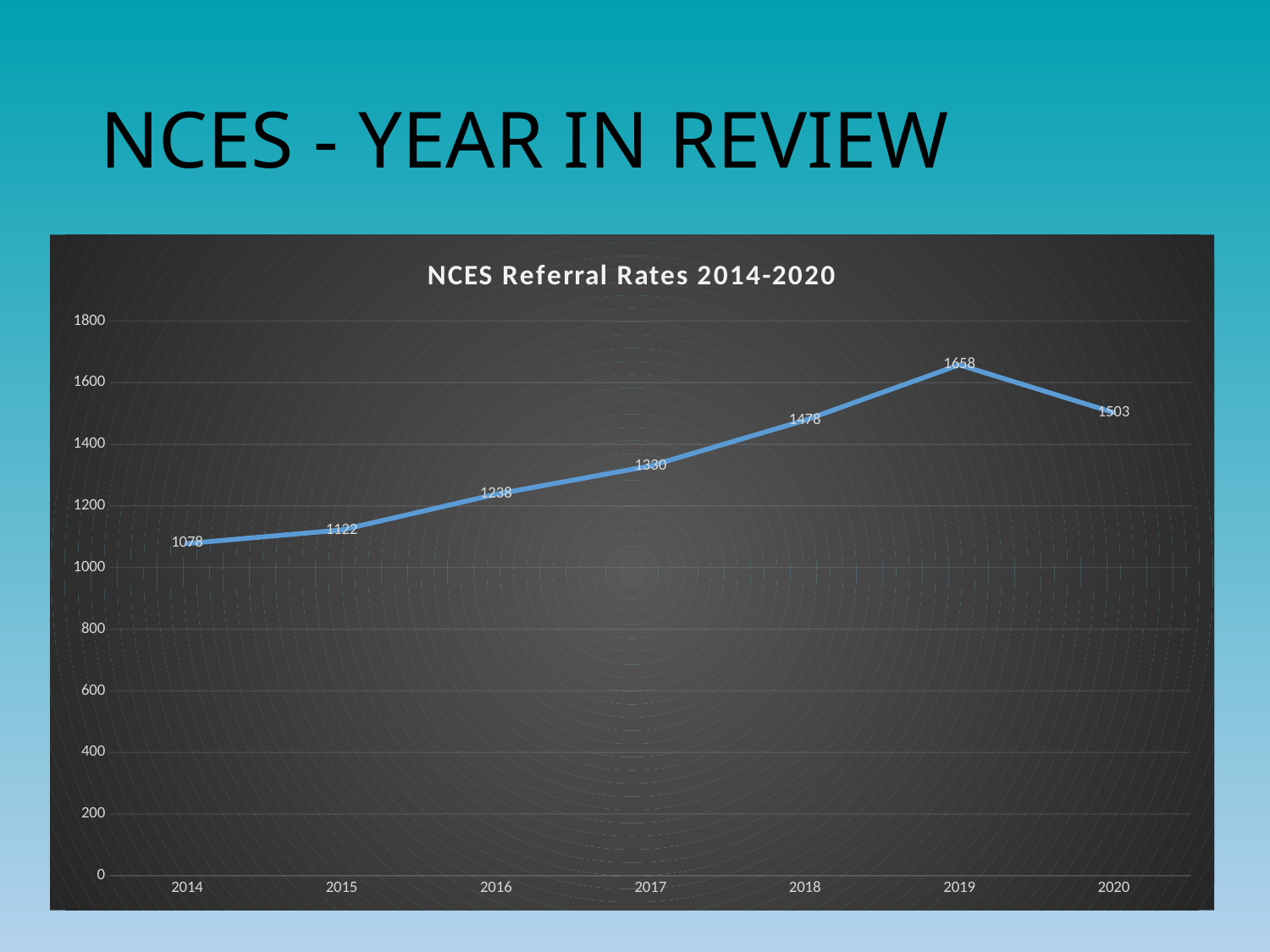
Which year has the highest NCES referral rate? 2019 Is the referral rate for 2019 greater or less than 1600? greater Which year has the lowest NCES referral rate? 2014 How many years are plotted on the chart? 7 What is the title of the chart? NCES Referral Rates 2014-2020 What is the NCES referral rate for 2017? 1330 What is the NCES referral rate for 2020? 1503 What is the NCES referral rate for 2014? 1078 What kind of chart is shown on the slide? line chart What is the difference between the referral rates for 2018 and 2014? 400 Which year has a higher referral rate, 2016 or 2018? 2018 What is the difference between the referral rates for 2019 and 2020? 155